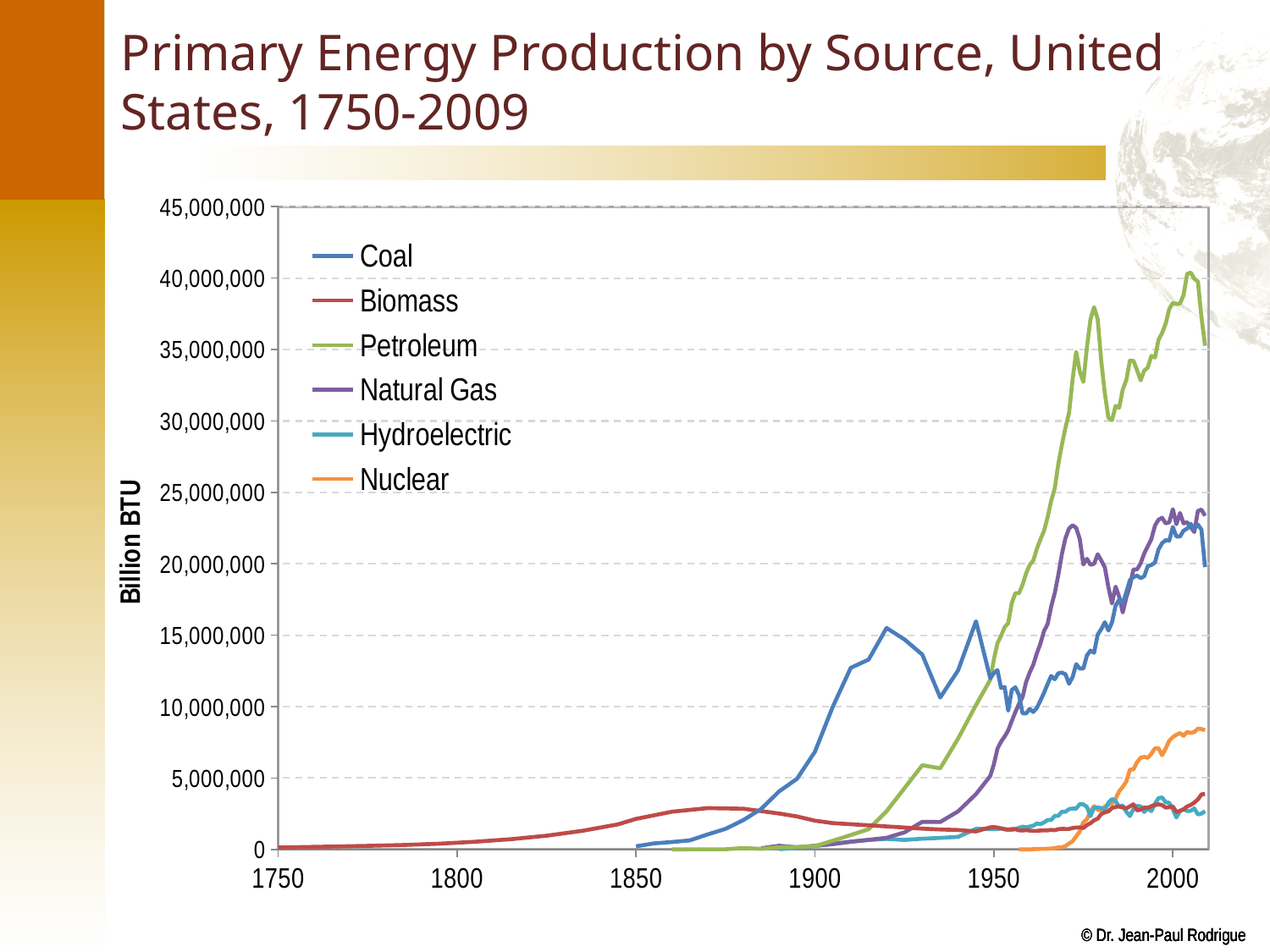
Which energy source reaches the highest value on the chart? Petroleum Is the peak value for Biomass around 1870 greater or less than 5,000,000? less In 2009, which is larger, Natural Gas or Hydroelectric? Natural Gas Which energy source has data plotted from 1750 onward? Biomass Does the Nuclear line rise or fall between 1960 and 2009? rise What kind of chart is shown on the slide? line chart Around 1900, which is larger, Coal or Petroleum? Coal How many series does the legend list? 6 Is the value for Natural Gas in 2009 greater or less than 20,000,000? greater What is the label on the vertical axis? Billion BTU Is the value for Nuclear in 2009 greater or less than 10,000,000? less